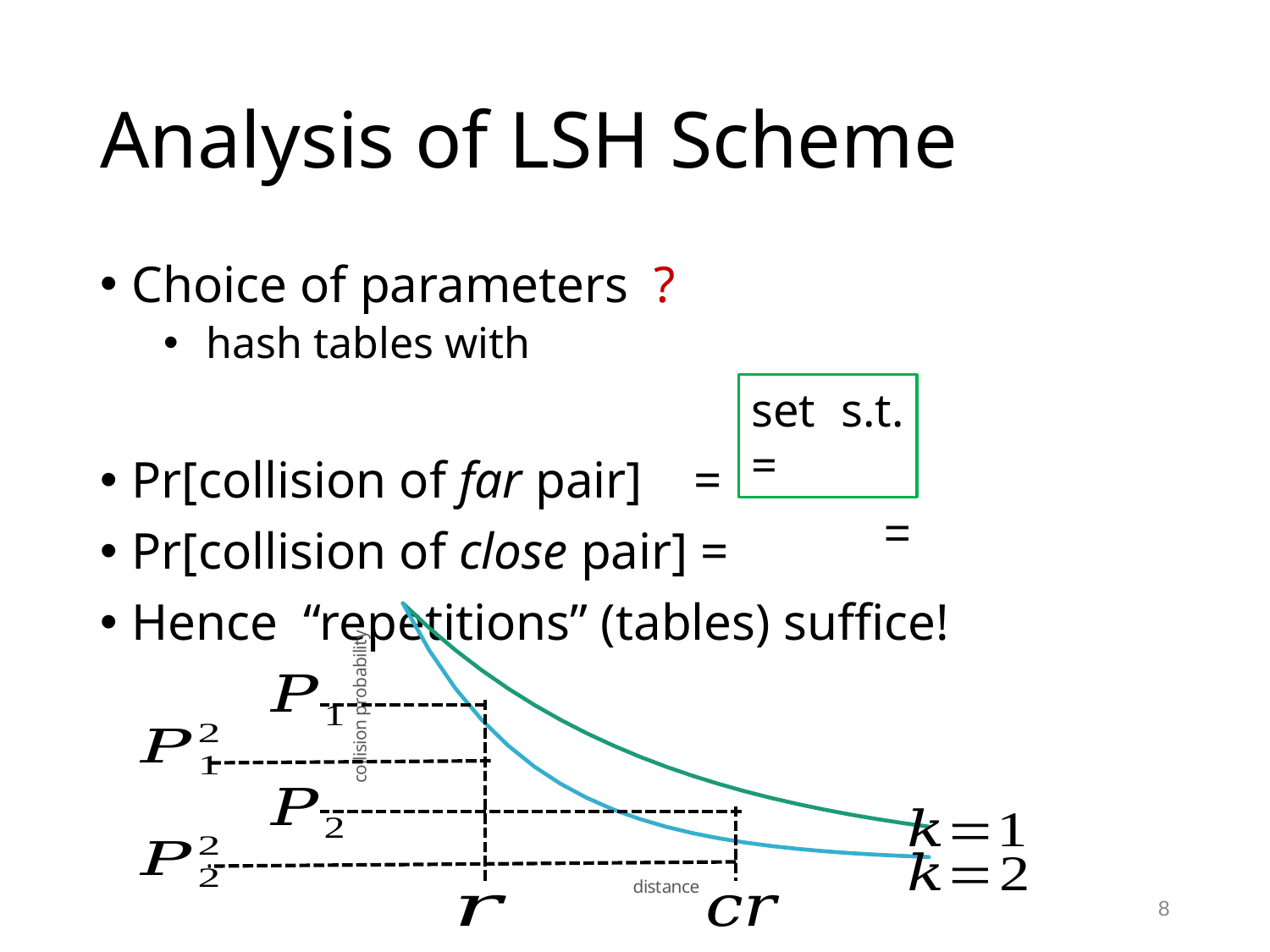
Which two distances are marked with dashed vertical lines on the horizontal axis? r and cr What kind of chart is shown at the bottom of the slide? line chart What is the label of the horizontal axis of the chart? distance What are the two curves in the chart labelled? k=1 and k=2 Which curve is lower at distance cr, k=1 or k=2? k=2 Which curve is higher at distance r, k=1 or k=2? k=1 Do the curves rise or fall as distance increases? fall Which curve decreases more steeply with distance, k=1 or k=2? k=2 Which is larger, the collision probability of the k=1 curve at distance r or at distance cr? at distance r How many curves are plotted in the chart? 2